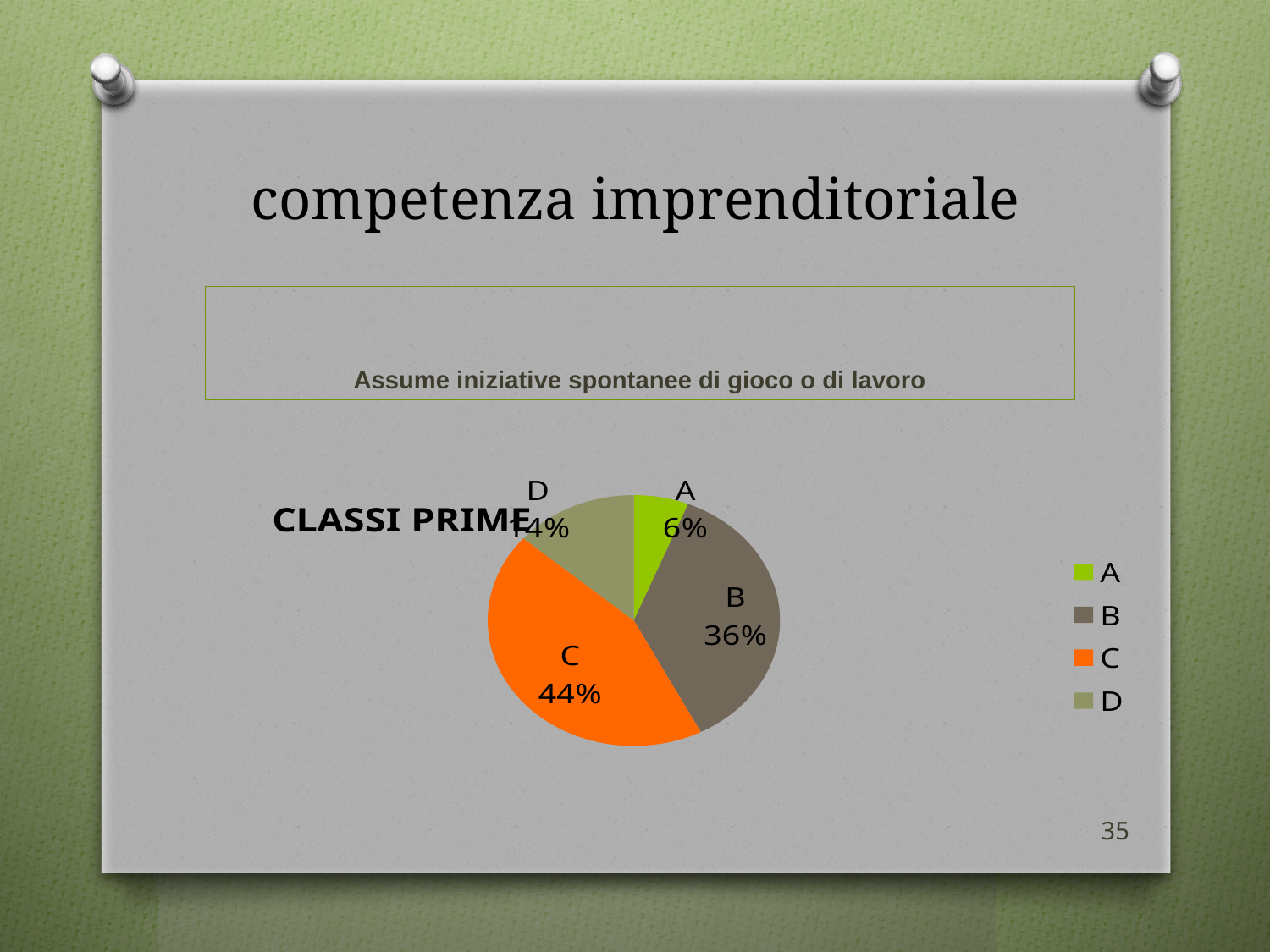
What colour is slice C in the pie chart? Orange Which category has the largest slice in the pie chart? C What percentage does slice A represent in the pie chart? 6% What is the difference in percentage points between slice C and slice B? 8% What percentage does slice B represent in the pie chart? 36% What entries are listed in the chart legend? A, B, C, D Which slice is larger, D or A? D What kind of chart is shown on the slide? Pie chart Which category has the smallest slice in the pie chart? A What percentage does slice C represent in the pie chart? 44% Which slice is larger, B or A? B How many slices does the pie chart have? 4